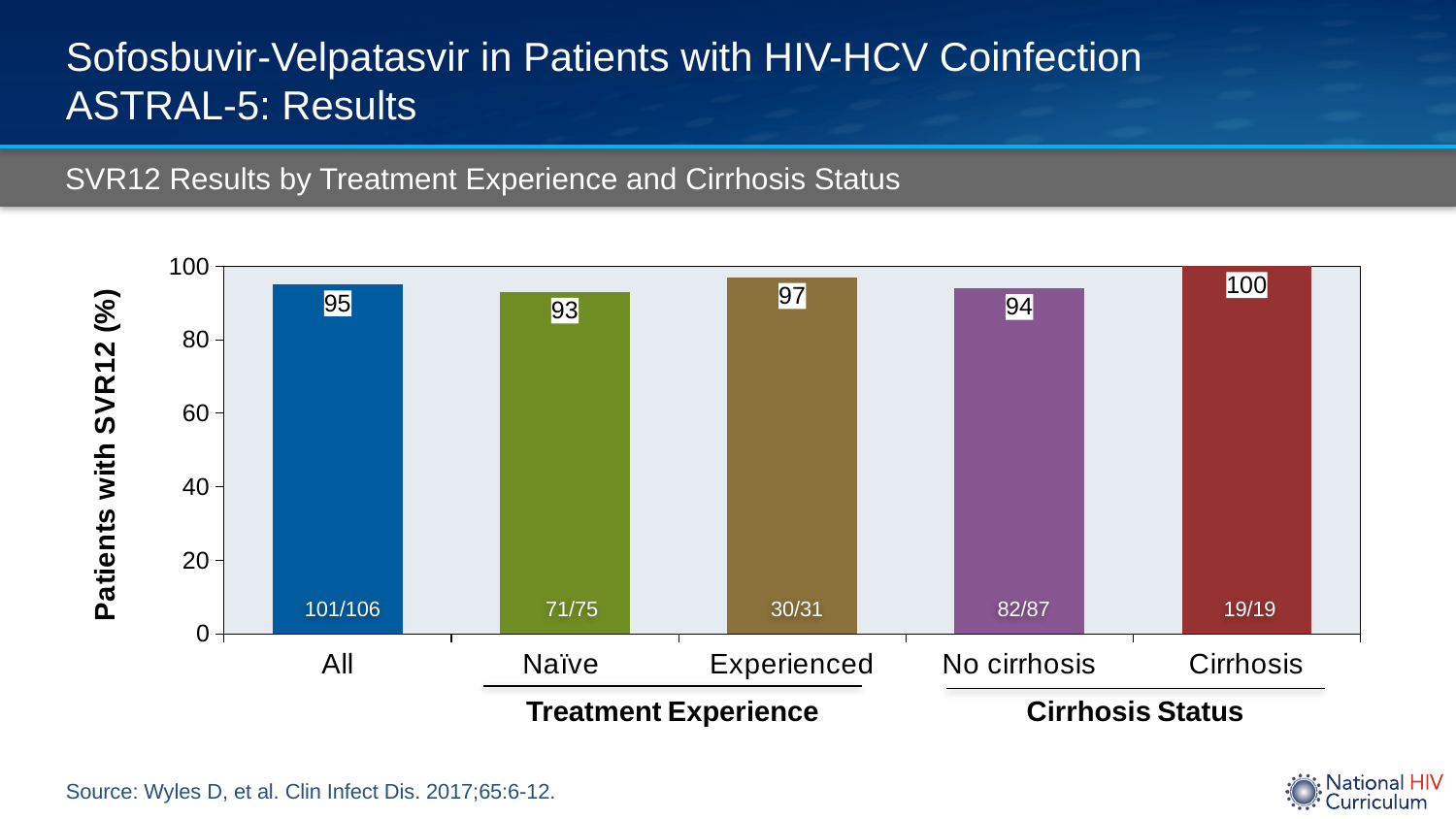
Which category has the highest SVR12 rate? Cirrhosis What is the label of the y axis? Patients with SVR12 (%) What is the SVR12 rate for treatment-naïve patients? 93 What is the SVR12 rate for the All group? 95 Which has a higher SVR12 rate, Naïve or Experienced? Experienced What is the SVR12 rate for the Cirrhosis group? 100 What type of chart is shown on the slide? Bar chart What is the title of the chart? SVR12 Results by Treatment Experience and Cirrhosis Status Which category has the lowest SVR12 rate? Naïve How many bars are shown in the chart? 5 What fraction of patients is shown inside the Experienced bar? 30/31 What is the difference in SVR12 rate between the Cirrhosis and No cirrhosis groups? 6